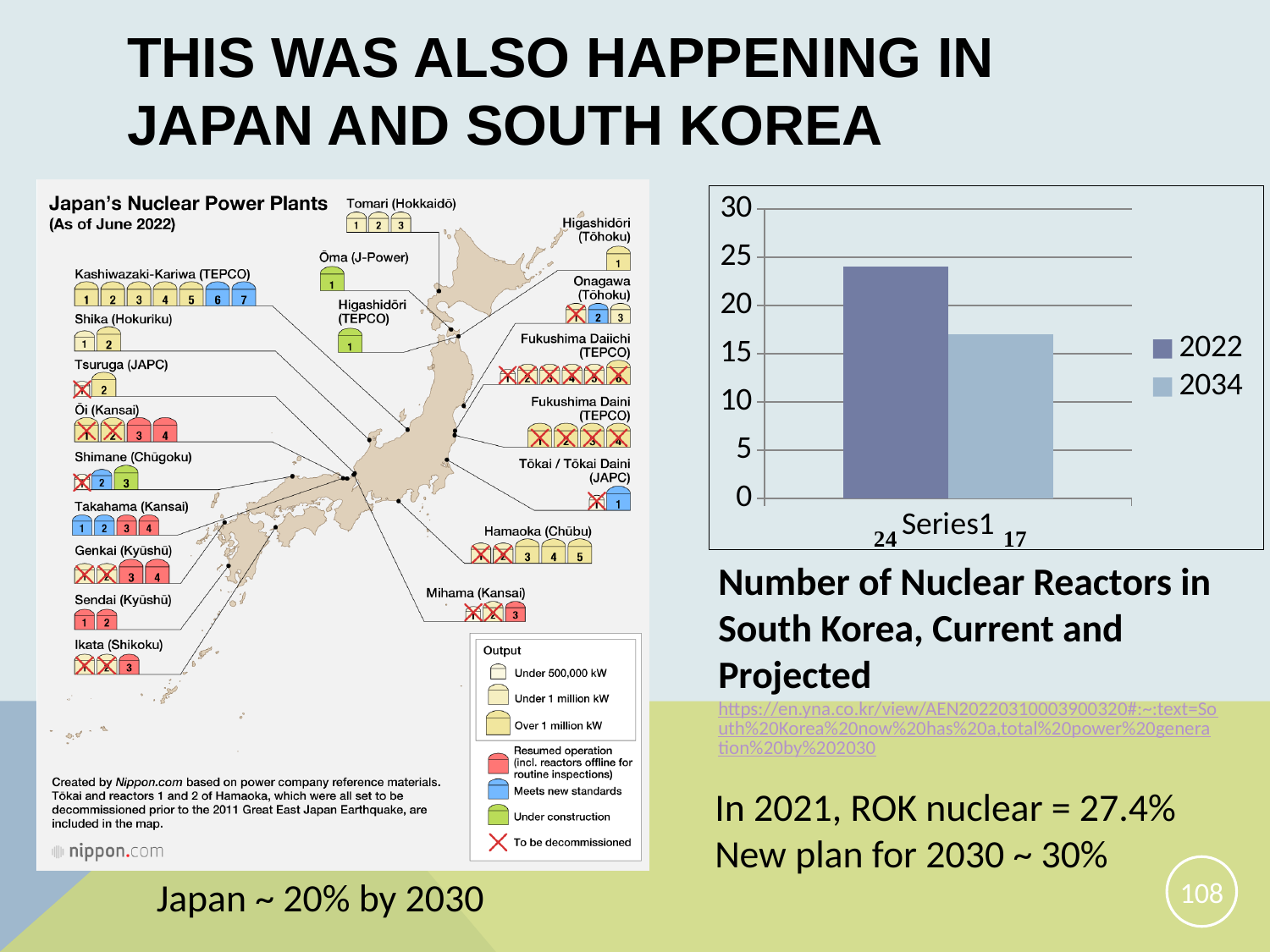
What type of chart is shown on the right side of the slide? bar chart Which series in the bar chart has the lowest value? 2034 Is the value for the 2022 series in the bar chart greater or less than 20? greater What is the category label shown on the horizontal axis of the bar chart? Series1 Which series in the bar chart has the higher value, 2022 or 2034? 2022 What is the difference between the 2022 value and the 2034 value in the bar chart? 7 Is the value for the 2034 series in the bar chart greater or less than 20? less What is the maximum value shown on the vertical axis of the bar chart? 30 In the bar chart, what is the value for the 2022 series? 24 How many series does the legend of the bar chart list? 2 In the bar chart, what is the value for the 2034 series? 17 How many bars are plotted in the bar chart? 2